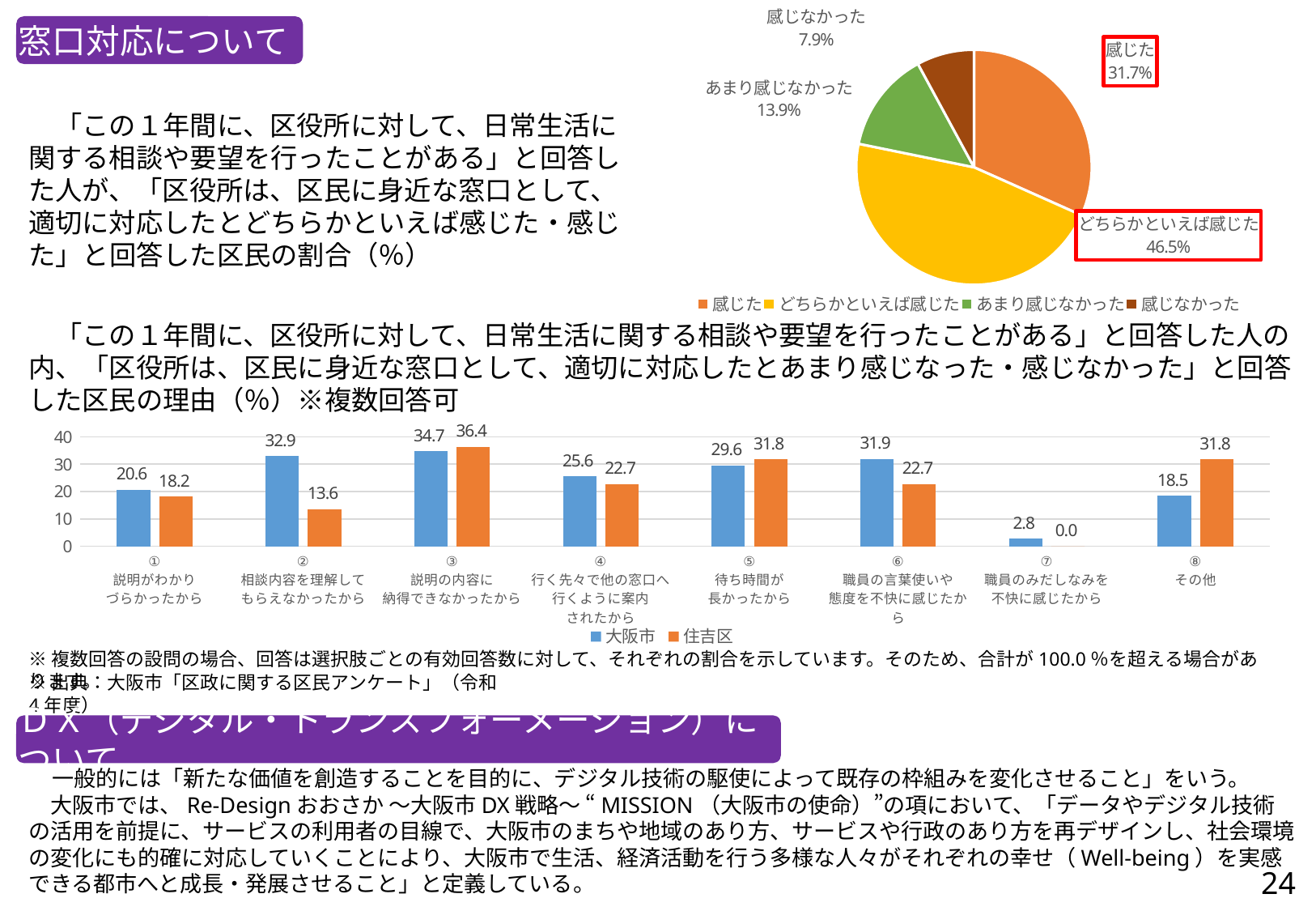
In the bar chart at the bottom, what is the value for 住吉区 in category ② 相談内容を理解してもらえなかったから? 13.6 In the bar chart at the bottom, for category ⑧ その他, which is larger, 大阪市 or 住吉区? 住吉区 In the bar chart at the bottom, how many series does the legend list? 2 In the pie chart at the top right, what is the value for 「感じなかった」? 7.9% In the pie chart at the top right, what share of respondents answered 「どちらかといえば感じた」? 46.5% In the pie chart at the top right, which category has the largest slice? どちらかといえば感じた In the bar chart at the bottom, what is the difference between 大阪市 and 住吉区 in category ⑥ 職員の言葉使いや態度を不快に感じたから? 9.2 In the bar chart at the bottom, which category has the lowest value for 住吉区? ⑦ 職員のみだしなみを不快に感じたから In the bar chart at the bottom, which category has the highest value for 大阪市? ③ 説明の内容に納得できなかったから In the pie chart at the top right, what is the difference between 「感じた」 and 「あまり感じなかった」? 17.8% In the pie chart at the top right, how many categories does the legend list? 4 What type of chart is the chart at the bottom of the slide? Bar chart